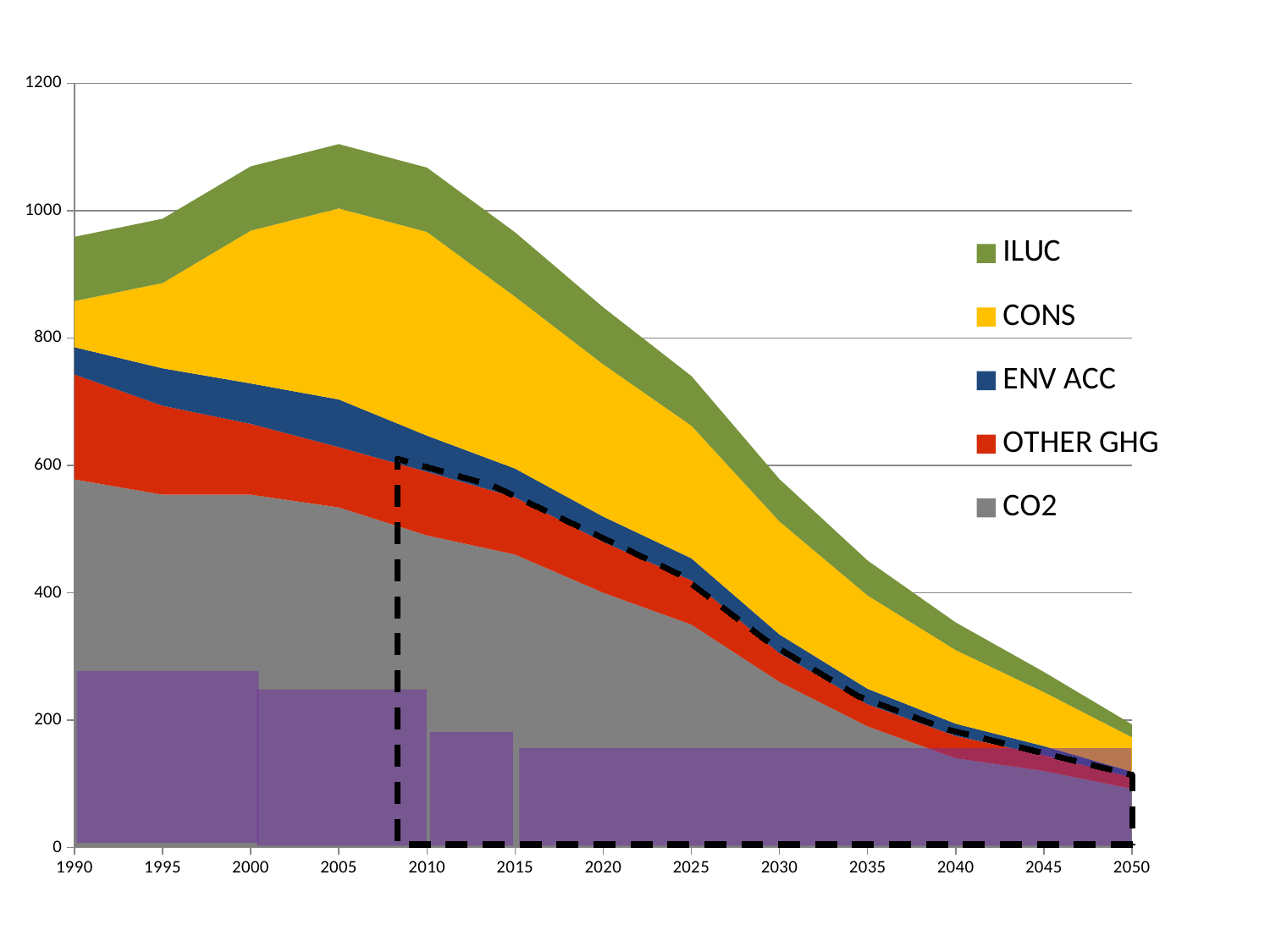
Is the total stacked value in 2050 greater or less than 400? less Is the total stacked value in 2005 greater or less than 1000? greater Which series is shown in grey at the bottom of the stack? CO2 Does the total stacked value rise or fall between 2005 and 2050? fall In which year is the total stacked value lowest? 2050 Which is larger, the total stacked value in 1990 or in 2050? 1990 What kind of chart is shown on the slide? stacked area chart Does the total stacked value rise or fall between 1990 and 2005? rise Is the CO2 value in 1990 greater or less than 400? greater How many series does the legend list? 5 In which year does the total stacked value reach its highest point? 2005 How many years are labelled along the x axis? 13